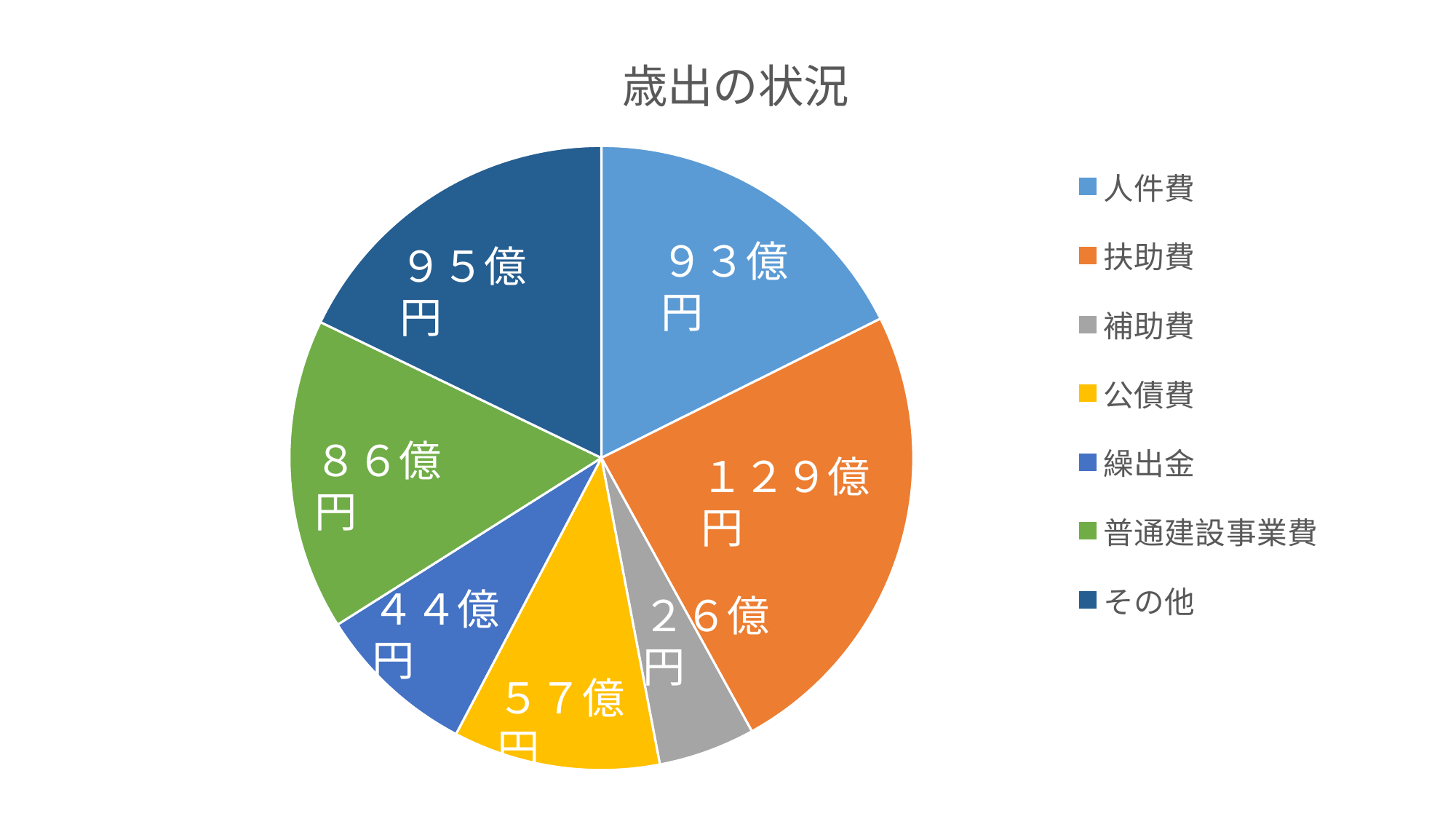
Which category has the smallest slice? 補助費 What kind of chart is shown on the slide? pie chart What colour is the slice for 公債費? yellow What is the value for 繰出金? ４４億円 What is the value for 人件費? ９３億円 What is the value for 扶助費? １２９億円 What is the value for 普通建設事業費? ８６億円 What is the chart's title? 歳出の状況 What is the difference between 扶助費 and 補助費? １０３億円 Which is larger, その他 or 人件費? その他 Which category has the largest slice? 扶助費 How many categories does the pie chart have? 7